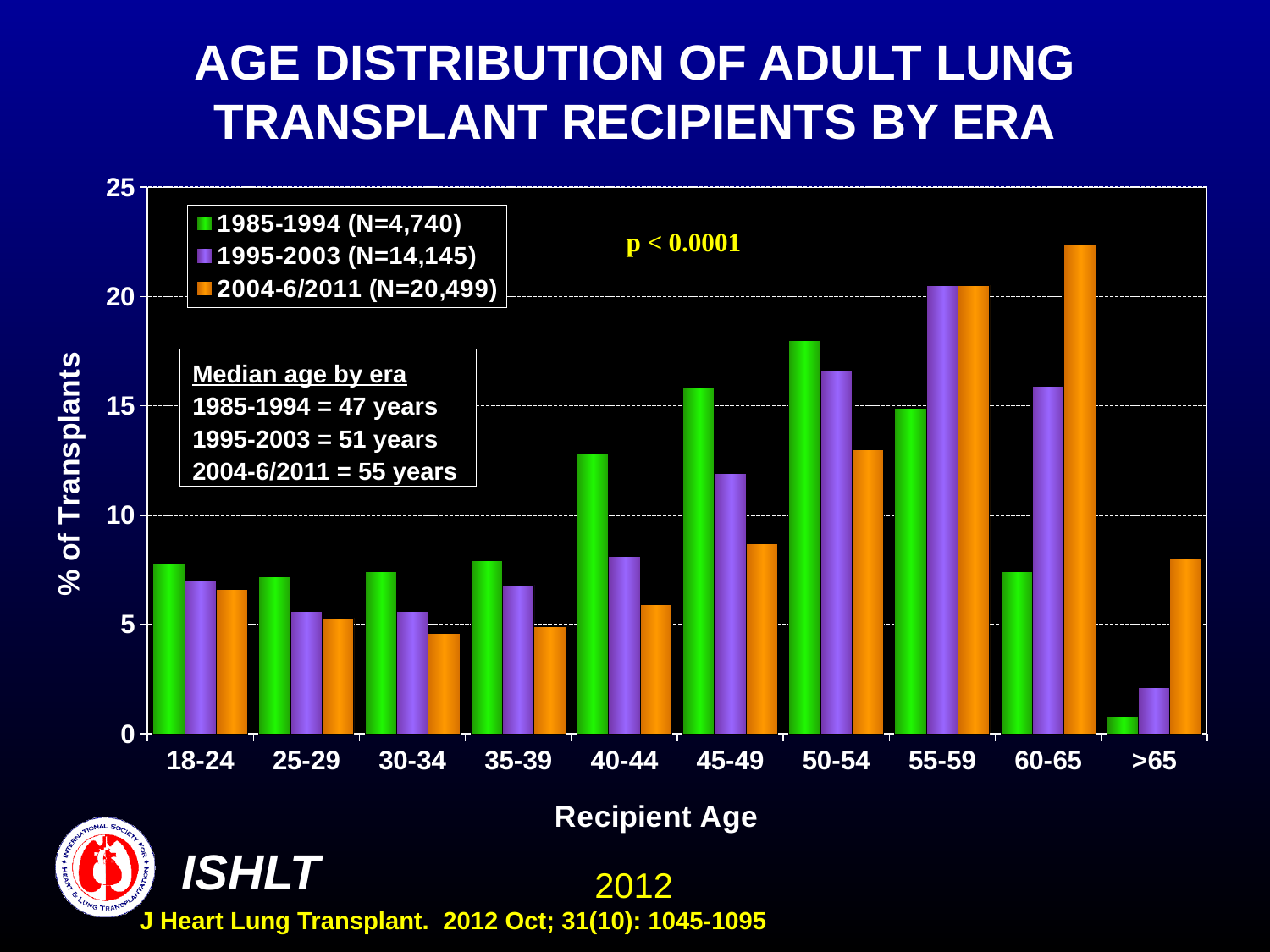
In the 45-49 age group, which era has the larger % of transplants: 1985-1994 or 2004-6/2011? 1985-1994 How many recipient age groups are shown on the x axis? 10 Is the value for the 1995-2003 era in the >65 age group greater or less than 5? less Is the value for the 2004-6/2011 era in the 60-65 age group greater or less than 20? greater According to the text box on the chart, what is the median age for the 2004-6/2011 era? 55 years What kind of chart is shown on the slide? bar chart In the 60-65 age group, which era has the larger % of transplants: 1985-1994 or 2004-6/2011? 2004-6/2011 For the 1985-1994 era, which recipient age group has the lowest % of transplants? >65 For the 1985-1994 era, which recipient age group has the highest % of transplants? 50-54 How many series does the legend list? 3 For the 2004-6/2011 era, which recipient age group has the highest % of transplants? 60-65 Is the value for the 1985-1994 era in the 40-44 age group greater or less than 10? greater